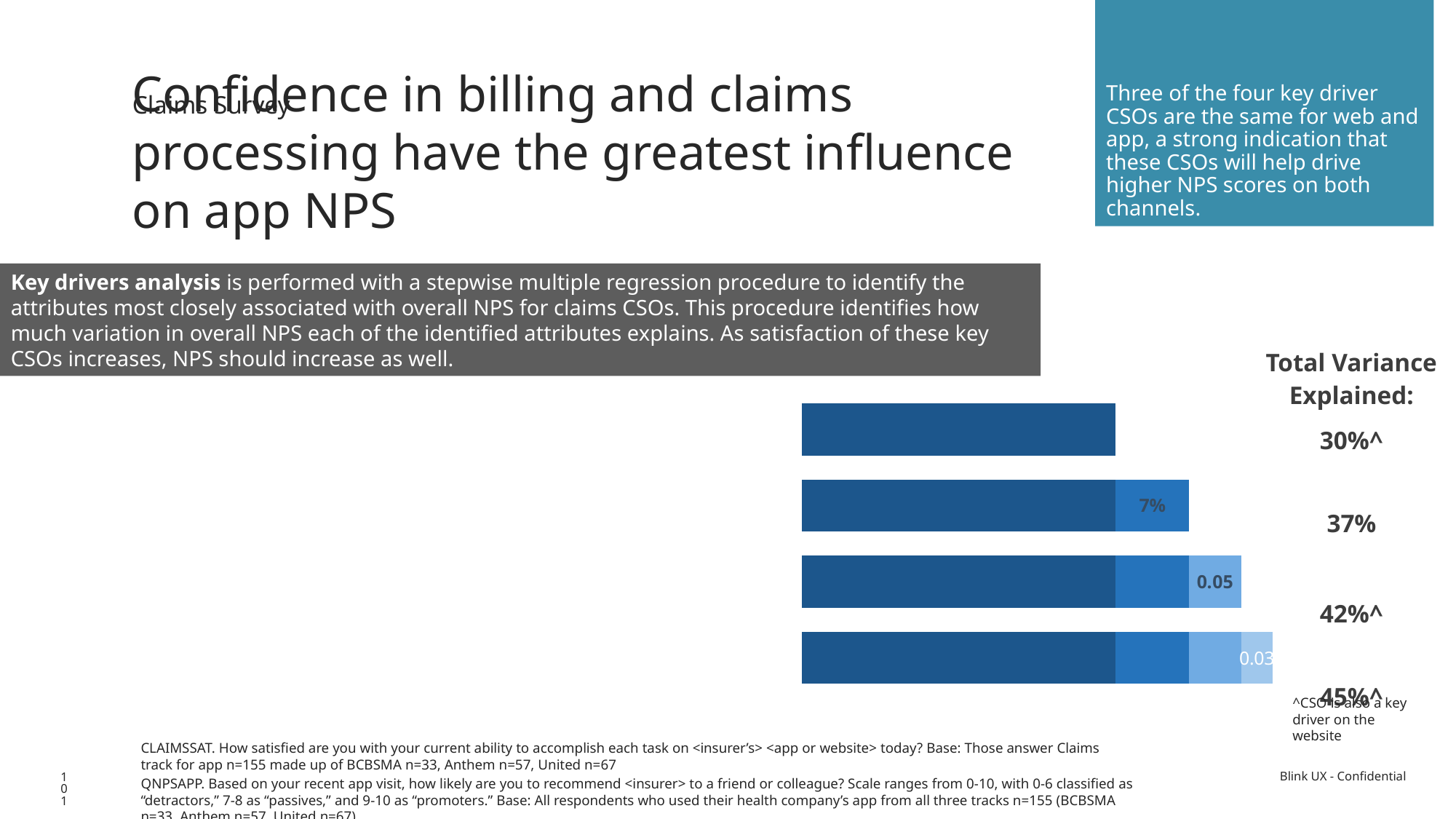
How many stacked segments make up the bottom bar? 4 Which bar in the chart is the longest overall? the bottom bar What type of chart is shown on the slide? bar chart How many bars does the chart contain? 4 What Total Variance Explained value is shown next to the bottom bar? 45%^ What is the difference between the Total Variance Explained values for the bottom bar (45%) and the top bar (30%)? 15% What data label is printed on the lighter blue segment of the second bar from the top? 7% What data label is printed on the lightest segment of the bottom bar? 0.03 What Total Variance Explained value is shown next to the top bar? 30%^ Do the bars get longer or shorter moving from the top bar to the bottom bar? longer Which bar in the chart is the shortest overall? the top bar What data label is printed on the lightest segment of the third bar from the top? 0.05